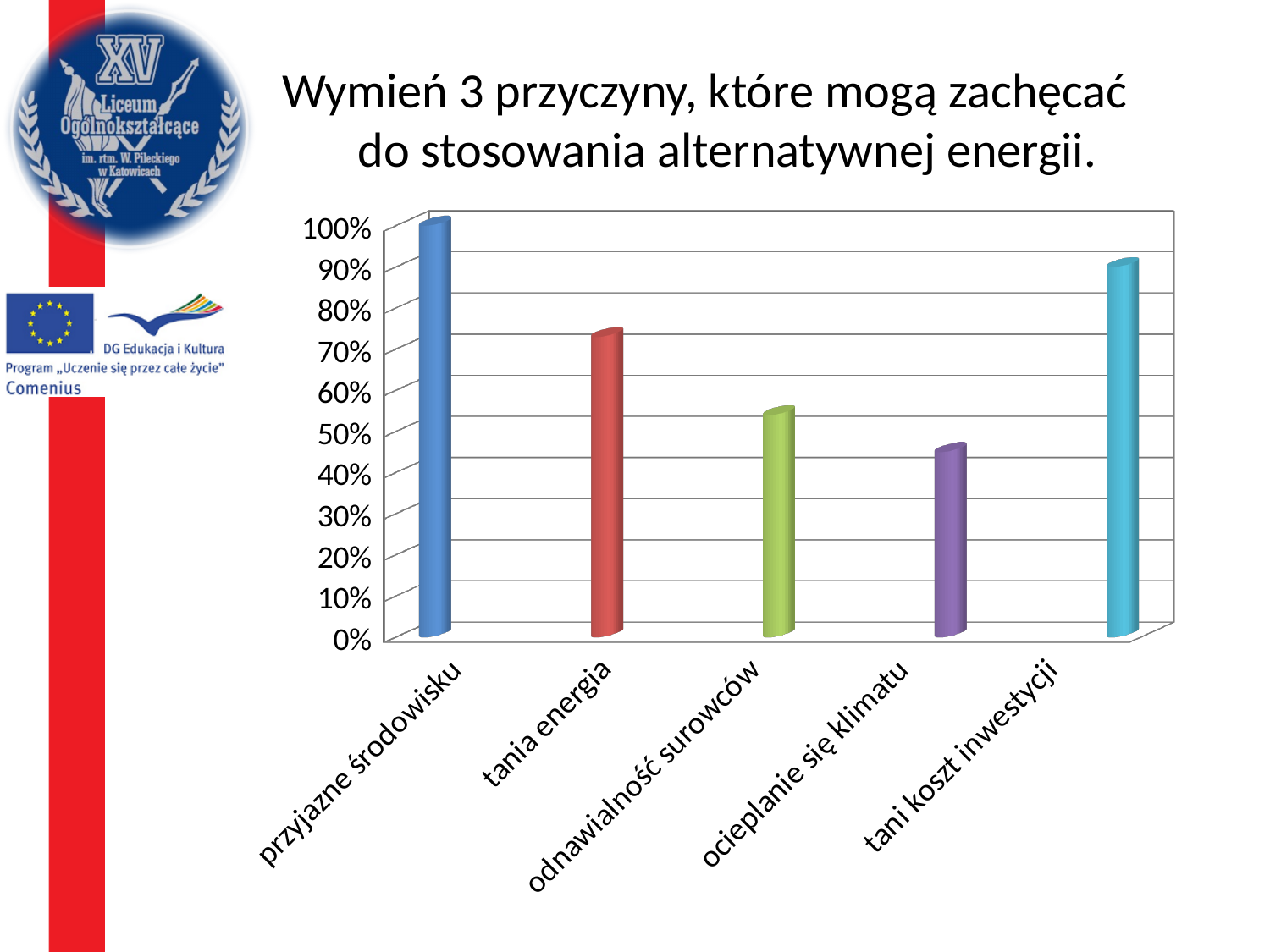
Which category has the lowest bar in the chart? ocieplanie się klimatu How many categories are shown on the x axis of the chart? 5 Is the value for tani koszt inwestycji greater or less than 80%? greater What kind of chart is shown on the slide? bar chart Is the value for odnawialność surowców greater or less than 60%? less Is the value for tania energia greater or less than 60%? greater Which category has the highest bar in the chart? przyjazne środowisku Which is larger, the value for tani koszt inwestycji or the value for ocieplanie się klimatu? tani koszt inwestycji Which is larger, the value for tania energia or the value for odnawialność surowców? tania energia What colour is the bar for przyjazne środowisku? blue